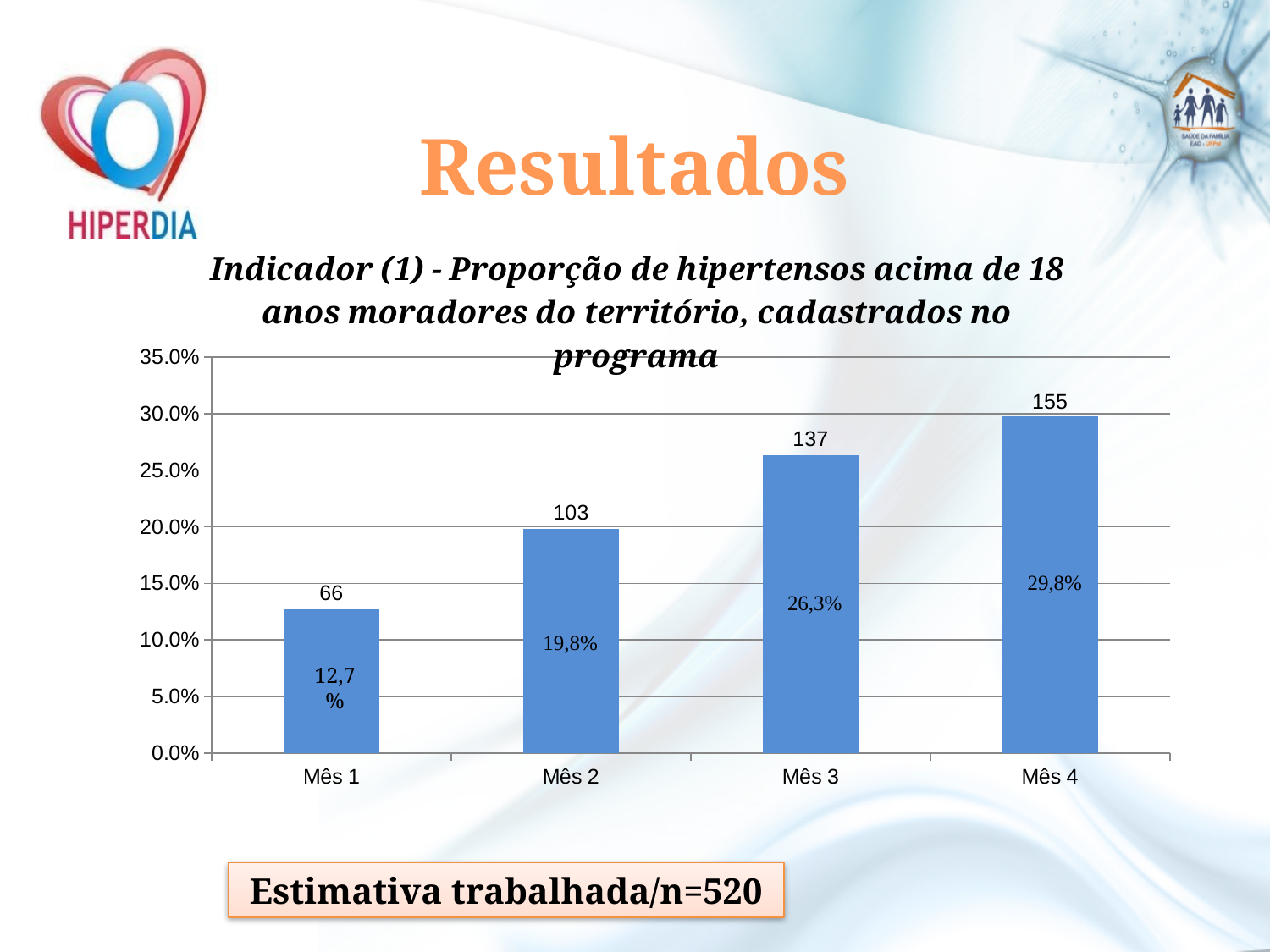
What number is printed above the bar for Mês 1? 66 What kind of chart is shown on the slide? Bar chart Do the values rise or fall from Mês 1 to Mês 4? Rise What number is printed above the bar for Mês 3? 137 Is the value for Mês 2 greater or less than 15.0%? greater Which month has the highest bar? Mês 4 How many months are shown on the x axis? 4 What percentage is shown inside the bar for Mês 4? 29,8% Which month has the lowest bar? Mês 1 What is the difference between the numbers printed above the bars for Mês 4 and Mês 1? 89 Which bar is taller, Mês 2 or Mês 3? Mês 3 What percentage is shown inside the bar for Mês 2? 19,8%